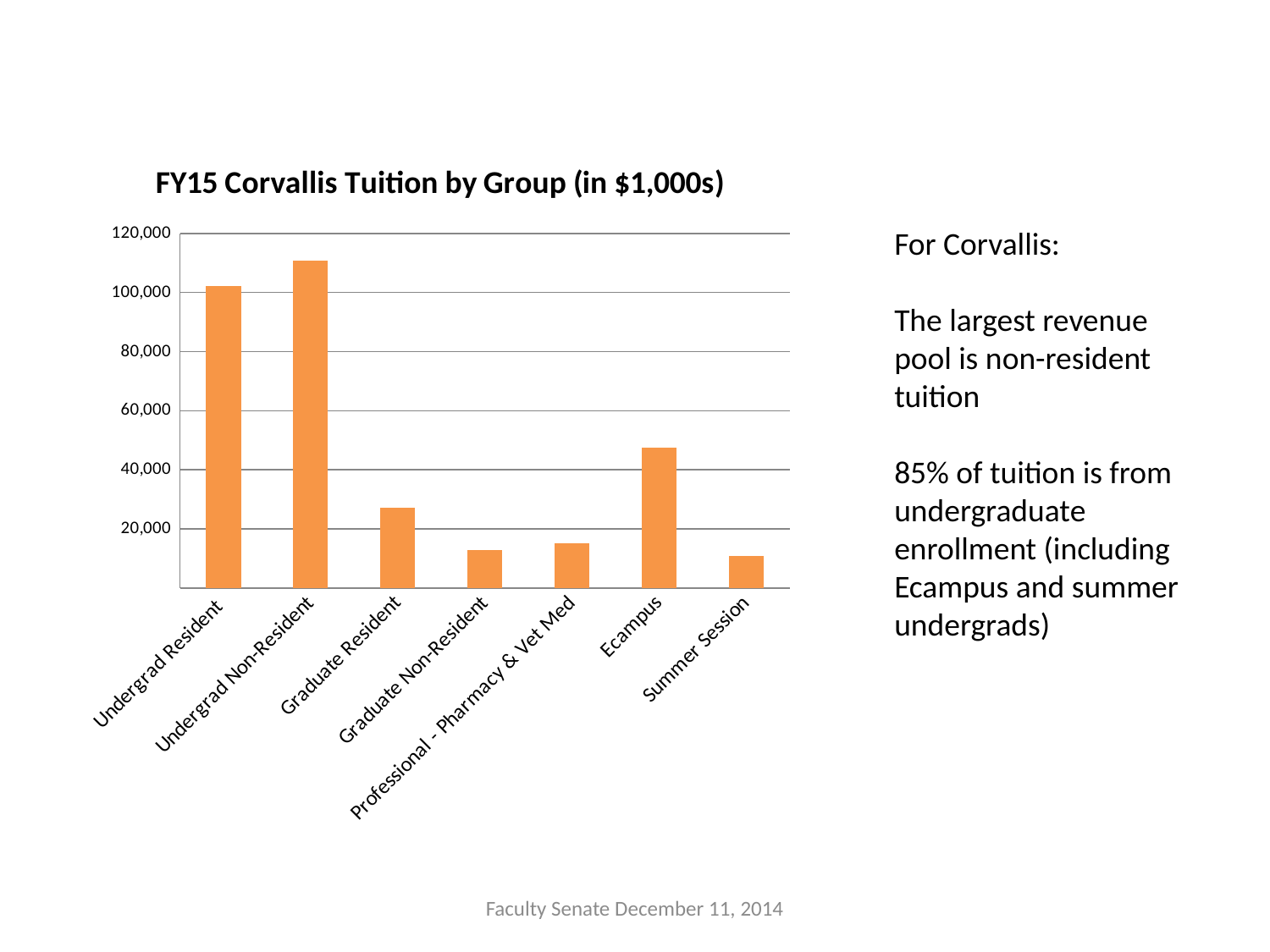
Which is larger, the value for Undergrad Resident or the value for Undergrad Non-Resident? Undergrad Non-Resident Is the value for Summer Session greater or less than 20,000? less What type of chart is shown on the slide? bar chart What is the title of the chart? FY15 Corvallis Tuition by Group (in $1,000s) What colour are the bars in the chart? orange Which group has the highest tuition value in the chart? Undergrad Non-Resident How many groups (categories) are plotted in the chart? 7 Is the value for Ecampus greater or less than 40,000? greater Which is larger, the value for Ecampus or the value for Graduate Resident? Ecampus Is the value for Undergrad Resident greater or less than 100,000? greater